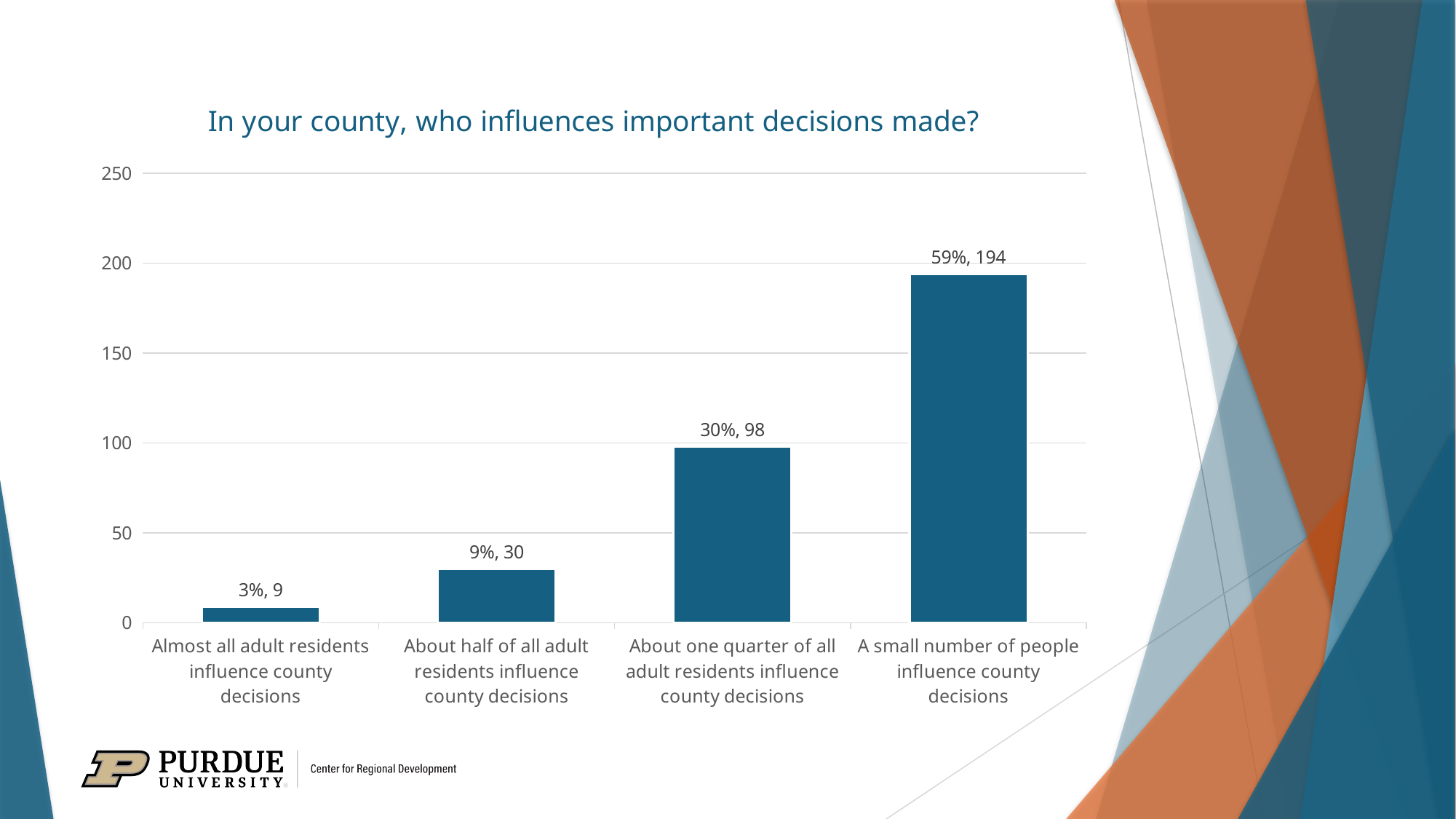
Which category has the highest value? A small number of people influence county decisions What is the difference in count between 'A small number of people influence county decisions' and 'About one quarter of all adult residents influence county decisions'? 96 What is the count for 'About half of all adult residents influence county decisions'? 30 How many categories are shown on the x axis? 4 What is the count for 'A small number of people influence county decisions'? 194 Which category has the lowest value? Almost all adult residents influence county decisions Do the values rise or fall from left to right along the x axis? rise What percentage is shown for 'About one quarter of all adult residents influence county decisions'? 30% Which is larger: the count for 'About half of all adult residents influence county decisions' or for 'Almost all adult residents influence county decisions'? About half of all adult residents influence county decisions What percentage is shown for 'Almost all adult residents influence county decisions'? 3% What is the chart's title? In your county, who influences important decisions made? What kind of chart is shown on the slide? bar chart